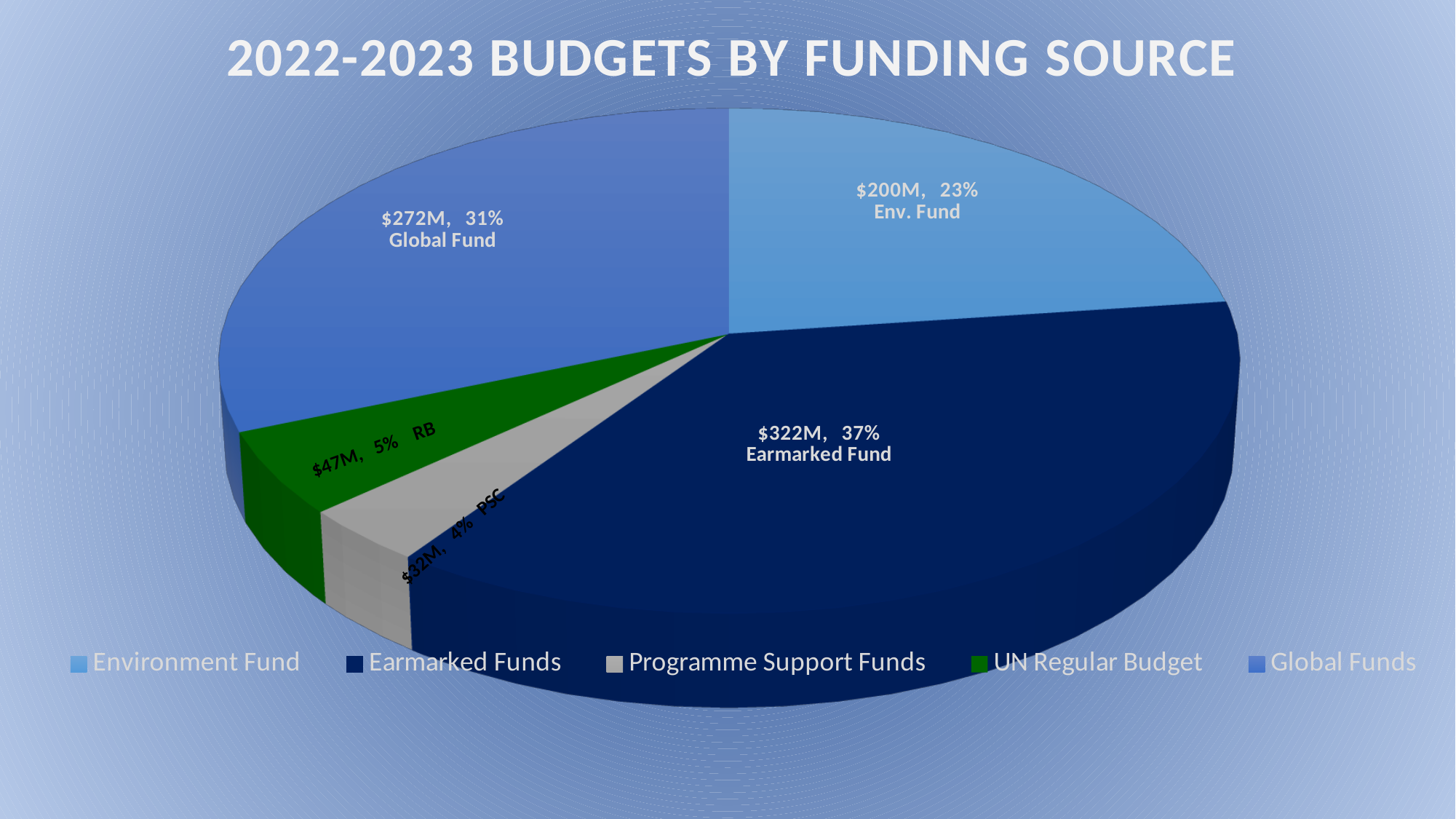
What percentage share does the UN Regular Budget (RB) slice have? 5% What is the budget amount for the Earmarked Fund slice? $322M What is the budget amount for the Programme Support Funds (PSC) slice? $32M How many funding sources are shown in the pie chart? 5 What is the difference in budget between the Earmarked Fund and the Global Fund? $50M Which funding source has the smallest share of the budget? Programme Support Funds What is the budget amount for the Global Fund slice? $272M What percentage share does the Environment Fund (Env. Fund) slice have? 23% Which funding source has the largest share of the budget? Earmarked Funds What type of chart is shown on the slide? Pie chart Which is larger, the Global Fund budget or the Environment Fund budget? Global Fund What is the title of the chart? 2022-2023 BUDGETS BY FUNDING SOURCE